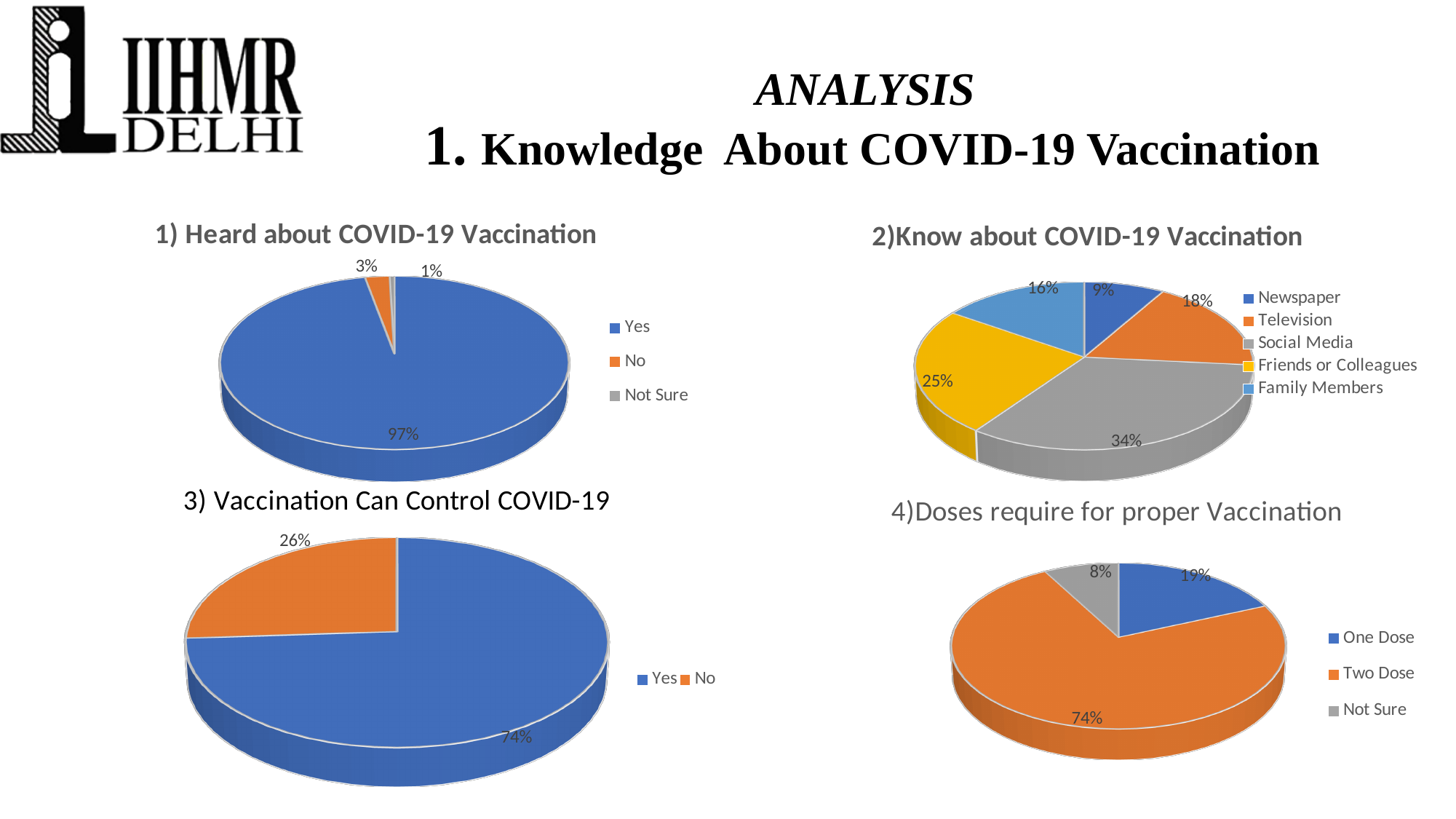
In the chart titled "2)Know about COVID-19 Vaccination", which source has the smallest share? Newspaper In the chart titled "2)Know about COVID-19 Vaccination", which source has the largest share? Social Media In the chart titled "3) Vaccination Can Control COVID-19", which answer is larger, Yes or No? Yes In the chart titled "3) Vaccination Can Control COVID-19", what share of respondents answered No? 26% In the chart titled "1) Heard about COVID-19 Vaccination", what share of respondents answered Yes? 97% In the chart titled "2)Know about COVID-19 Vaccination", how many sources does the legend list? 5 What kind of chart is used for "4)Doses require for proper Vaccination"? Pie chart In the chart titled "4)Doses require for proper Vaccination", what is the difference between the One Dose share and the Not Sure share? 11% In the chart titled "2)Know about COVID-19 Vaccination", what is the difference between the Television share and the Family Members share? 2% In the chart titled "2)Know about COVID-19 Vaccination", what is the share for Friends or Colleagues? 25% In the chart titled "4)Doses require for proper Vaccination", what share of respondents chose Two Dose? 74% In the chart titled "1) Heard about COVID-19 Vaccination", what share of respondents answered Not Sure? 1%